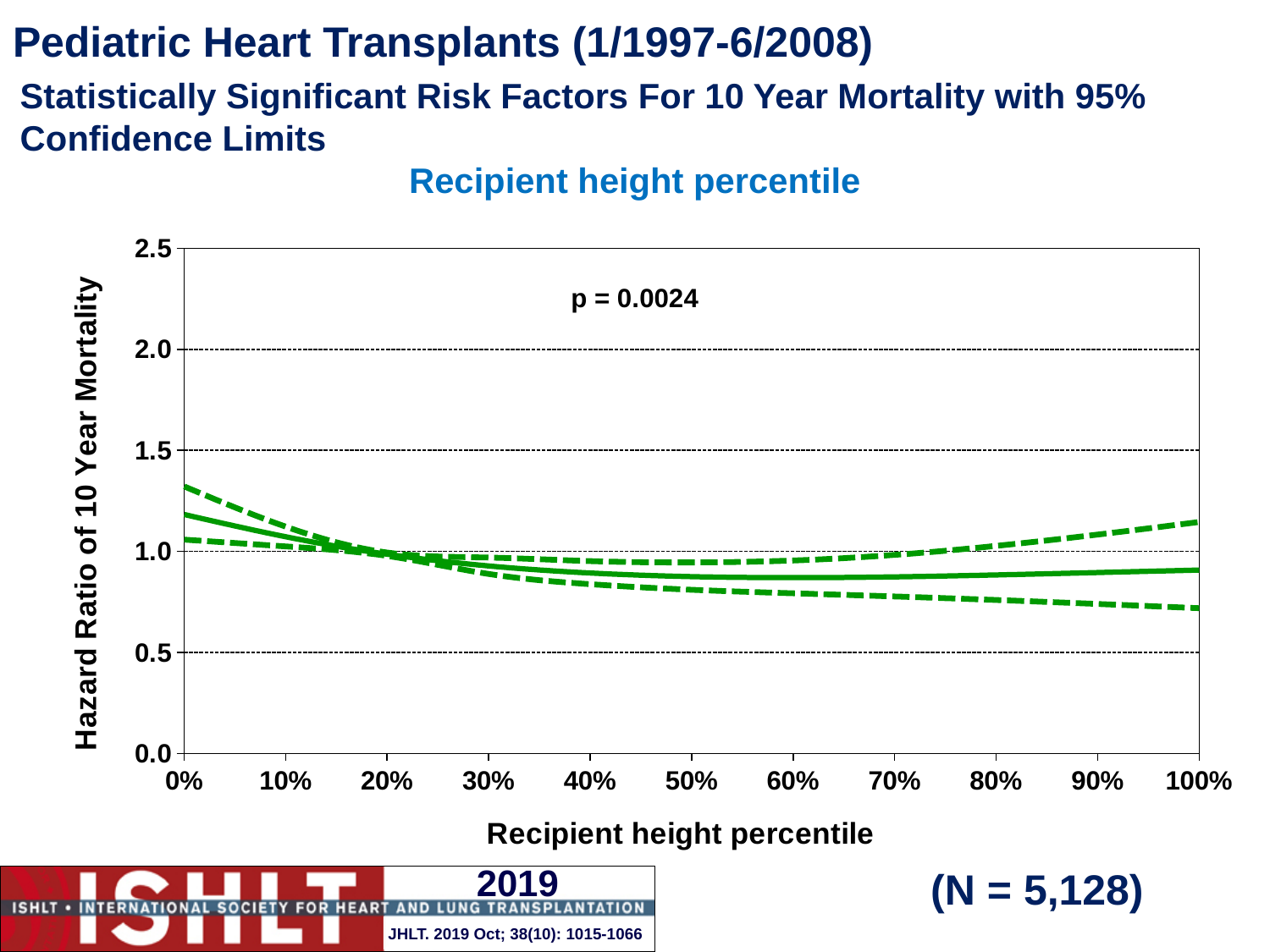
Is the value of the solid hazard ratio line at 100% recipient height percentile greater or less than 1.0? less How many tick labels are shown on the x axis? 11 What is the highest value labelled on the y axis? 2.5 Is the value of the upper dashed confidence limit at 0% recipient height percentile greater or less than 1.5? less How many lines are plotted on the chart? 3 What kind of chart is shown on the slide? line chart What p-value is printed on the chart? p = 0.0024 Is the value of the lower dashed confidence limit at 100% recipient height percentile greater or less than 0.5? greater Does the solid hazard ratio line rise or fall between 0% and 50% recipient height percentile? fall What is the title of the chart? Recipient height percentile